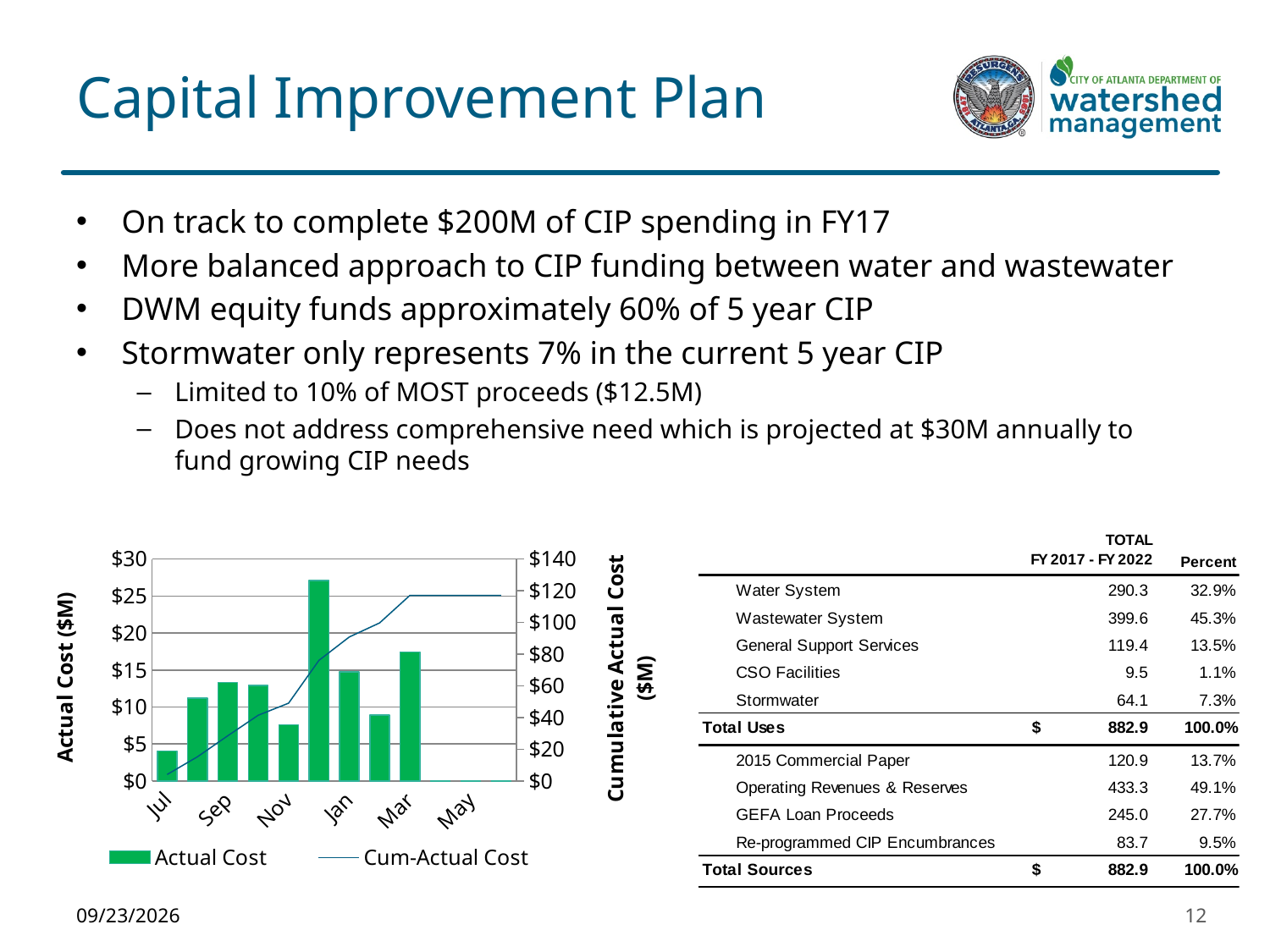
What kind of chart is shown at the bottom left of the slide? A bar chart with a line Which has the larger Actual Cost, Mar or Nov? Mar Which month has the lowest Actual Cost bar in the chart? Jul Is the Actual Cost value for Jul greater or less than $5? less What is the title of the left vertical axis of the chart? Actual Cost ($M) Does the Cum-Actual Cost line rise or fall from Jul to Mar? Rises Is the Cum-Actual Cost value at Mar greater or less than $100? greater How many series does the legend of the chart list? 2 Is the Actual Cost value for Mar greater or less than $15? greater Which has the larger Actual Cost, Sep or Jul? Sep